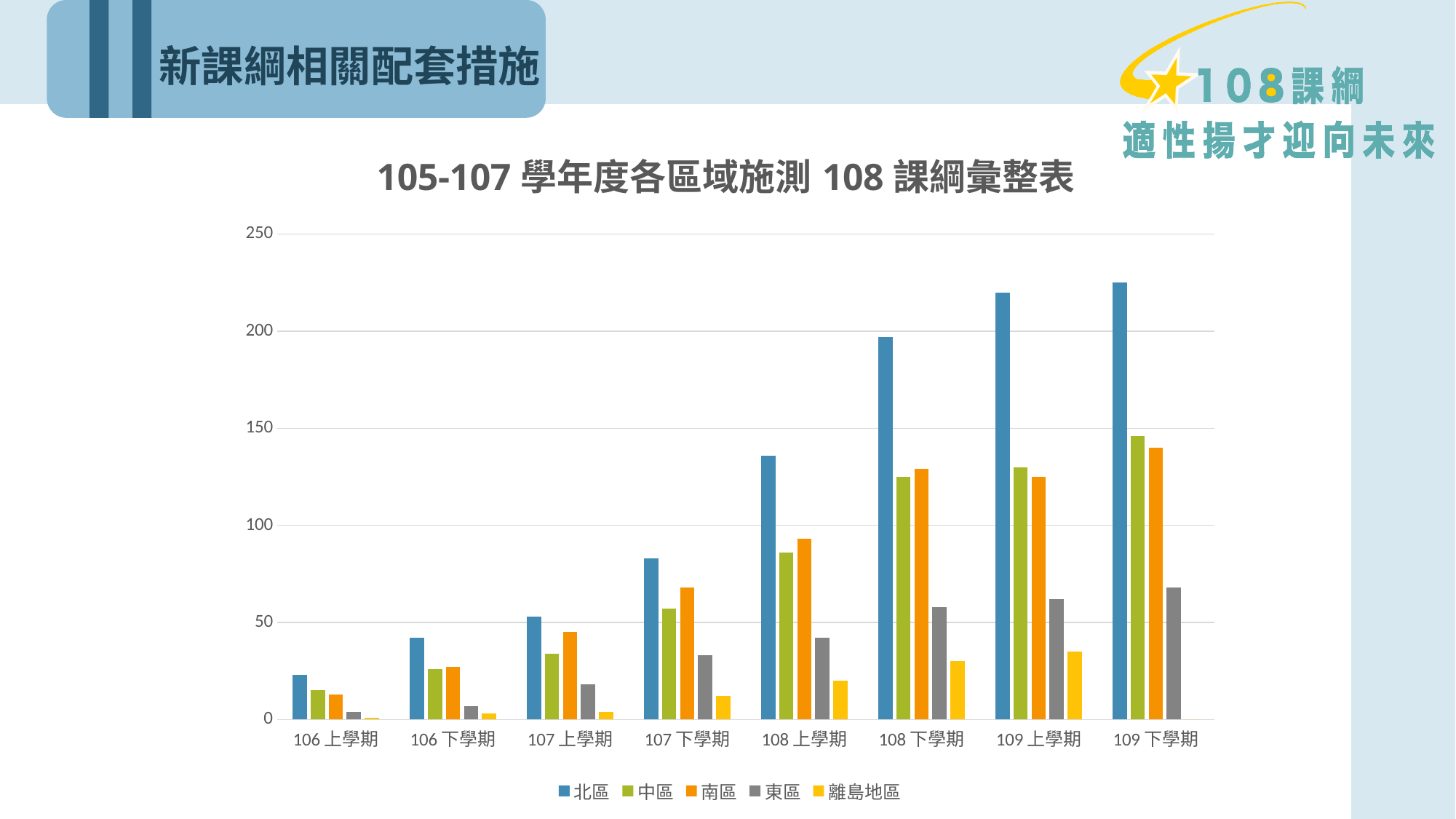
Is the value for 東區 in 109 下學期 greater or less than 50? greater What kind of chart is shown on the slide? bar chart Is the value for 北區 in 109 下學期 greater or less than 200? greater In 108 下學期, which is larger: the value for 北區 or the value for 南區? 北區 Is the value for 北區 in 108 上學期 greater or less than 150? less Do the values for 北區 rise or fall from 106 上學期 to 109 下學期? rise Which semester has the lowest value for 北區? 106 上學期 What is the title of the chart? 105-107 學年度各區域施測 108 課綱彙整表 How many series does the legend list? 5 Which semester has the highest value for 北區? 109 下學期 How many semester categories are shown on the x axis? 8